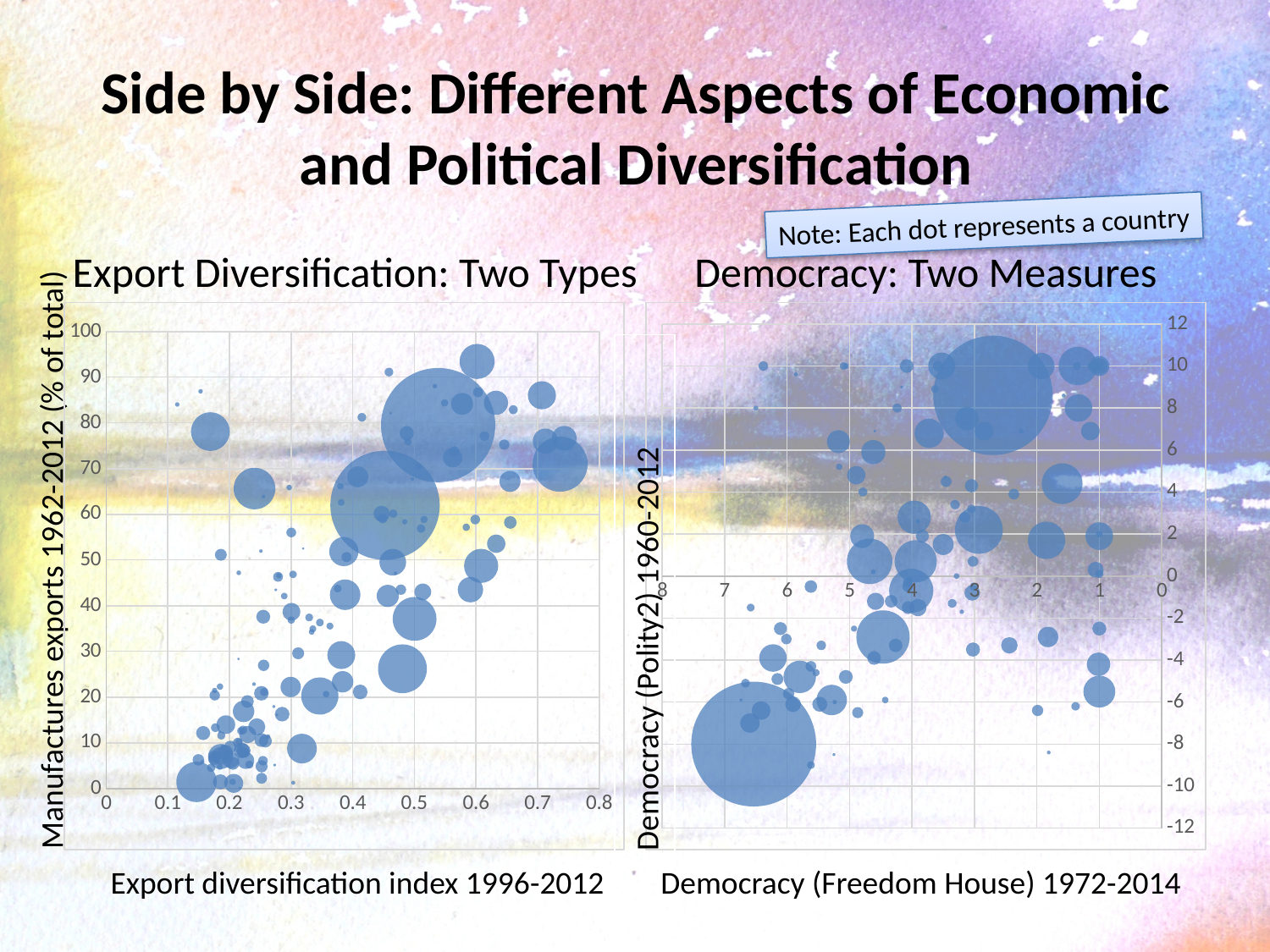
What is the highest value shown on the y axis of the left chart (Export Diversification: Two Types)? 100 What kind of chart is the left chart titled "Export Diversification: Two Types"? bubble chart In the left chart (Export Diversification: Two Types), is the x value of the largest bubble greater or less than 0.4? greater What kind of chart is the right chart titled "Democracy: Two Measures"? bubble chart What is the title of the right chart? Democracy: Two Measures In the right chart (Democracy: Two Measures), do the bubbles generally rise or fall moving from left to right along the x axis? rise In the left chart (Export Diversification: Two Types), do the bubbles generally rise or fall as the export diversification index increases along the x axis? rise In the left chart (Export Diversification: Two Types), is the y value of the largest bubble greater or less than 50? greater